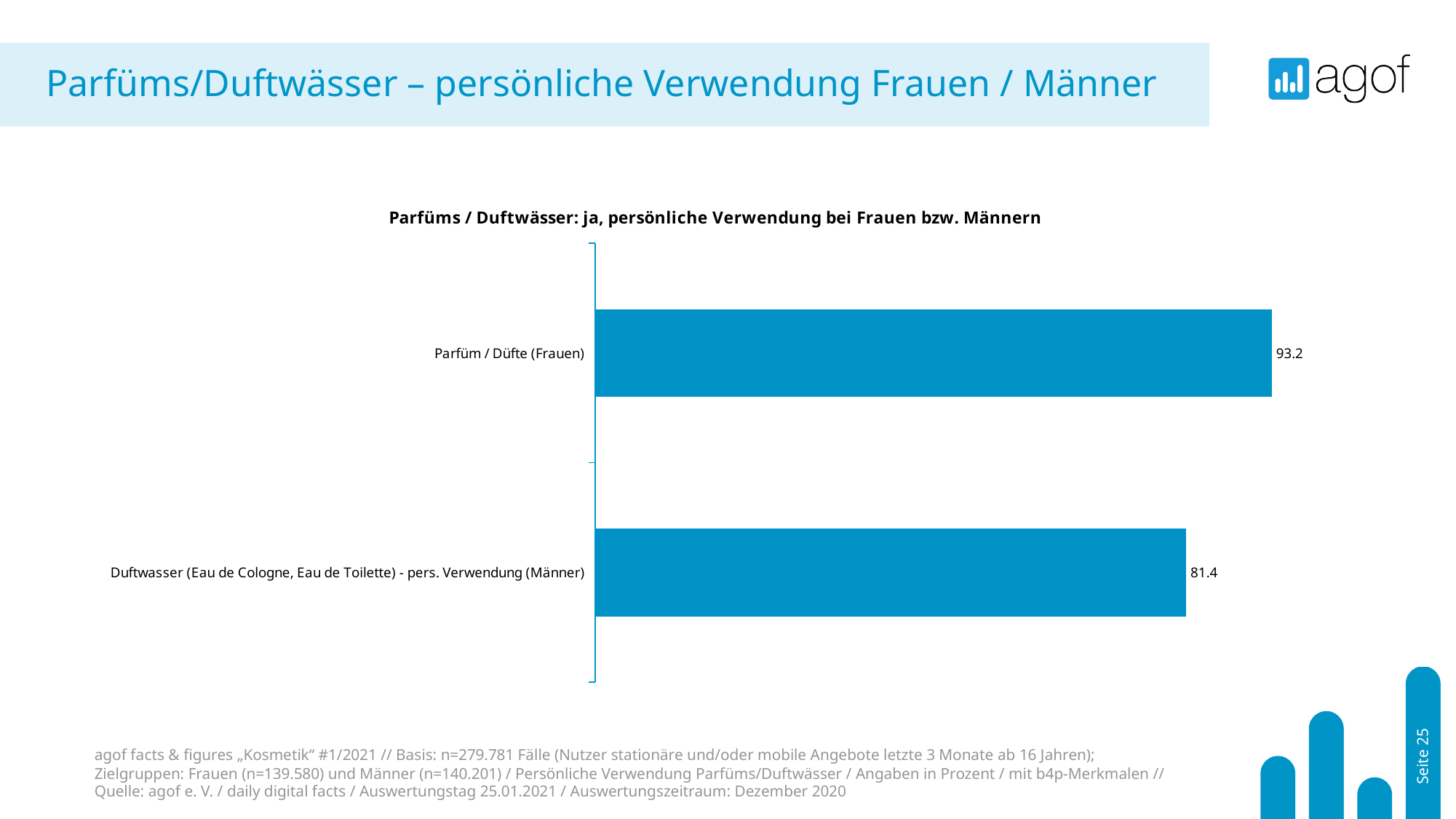
Which category has the lowest value? Duftwasser (Eau de Cologne, Eau de Toilette) - pers. Verwendung (Männer) What is the title of the chart? Parfüms / Duftwässer: ja, persönliche Verwendung bei Frauen bzw. Männern What is the value for Parfüm / Düfte (Frauen)? 93.2 How many categories are shown in the chart? 2 What colour are the bars in the chart? Blue Which is larger: the value for Parfüm / Düfte (Frauen) or the value for Duftwasser (Männer)? Parfüm / Düfte (Frauen) What is the difference between the value for Parfüm / Düfte (Frauen) and the value for Duftwasser (Männer)? 11.8 What kind of chart is shown on the slide? Bar chart Which category has the highest value? Parfüm / Düfte (Frauen) What is the value for Duftwasser (Eau de Cologne, Eau de Toilette) - pers. Verwendung (Männer)? 81.4